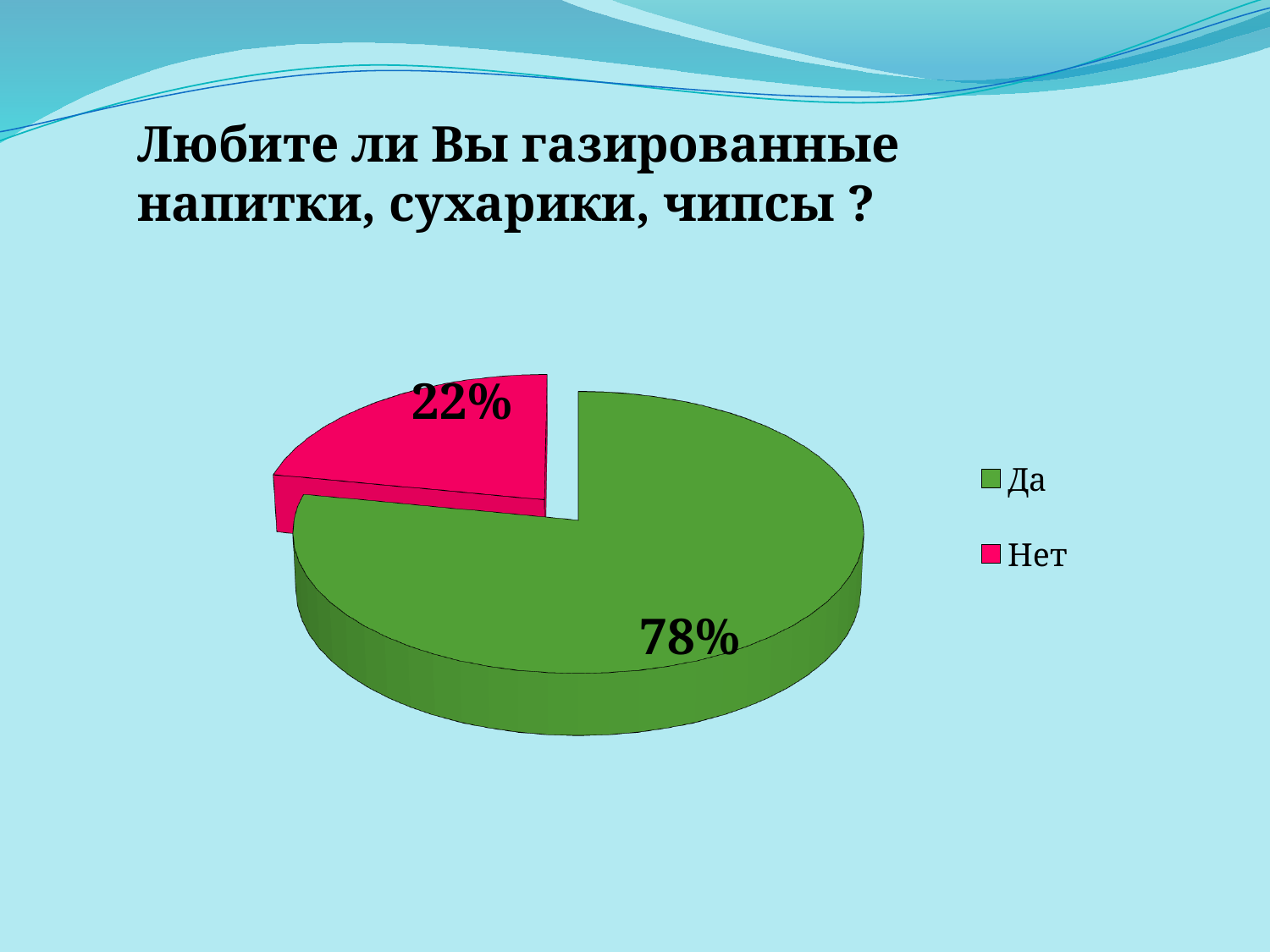
What colour is the "Нет" slice? Pink What percentage of respondents answered "Да"? 78% Which answer has the smallest share of the pie? Нет What share of the pie does the "Нет" slice represent? 22% Which answer has the largest share of the pie? Да Which is larger, the share for "Да" or the share for "Нет"? Да What percentage of respondents answered "Нет"? 22% How many entries does the legend list? 2 What colour is the "Да" slice? Green How many slices does the pie chart have? 2 What is the difference in percentage points between the "Да" and "Нет" slices? 56 What kind of chart is shown on the slide? Pie chart